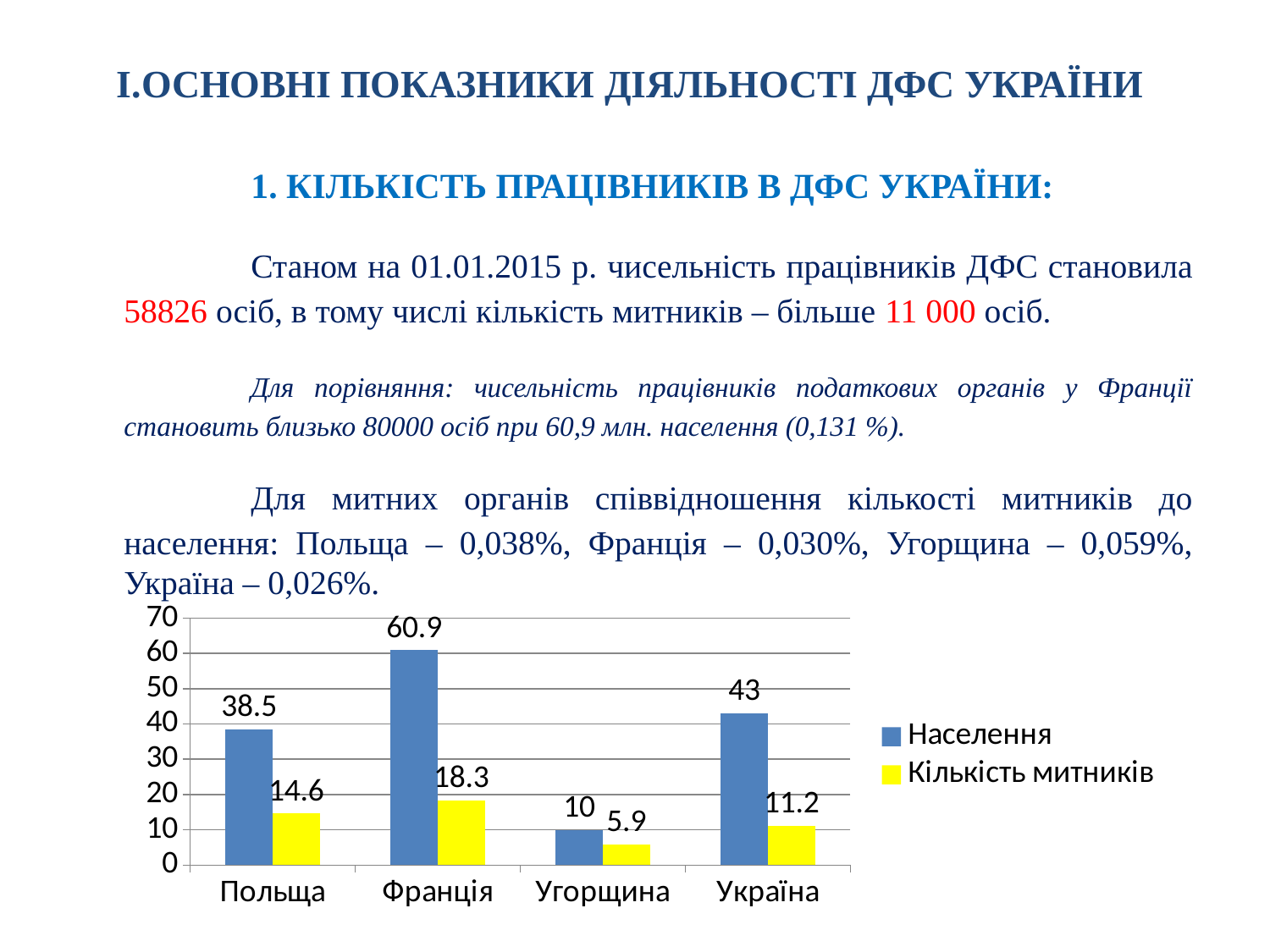
Which is larger: Кількість митників for Франція or for Україна? Франція What is the value of Кількість митників for Польща? 14.6 Which category has the lowest Кількість митників value? Угорщина What is the value of Кількість митників for Угорщина? 5.9 What kind of chart is shown on the slide? bar chart What is the value of Населення for Україна? 43 Which category has the highest Населення value? Франція What is the difference between the Населення values for Франція and Польща? 22.4 What is the value of Населення for Франція? 60.9 How many categories are shown on the x axis of the chart? 4 What colour are the Кількість митників bars in the chart? yellow How many series does the chart legend list? 2